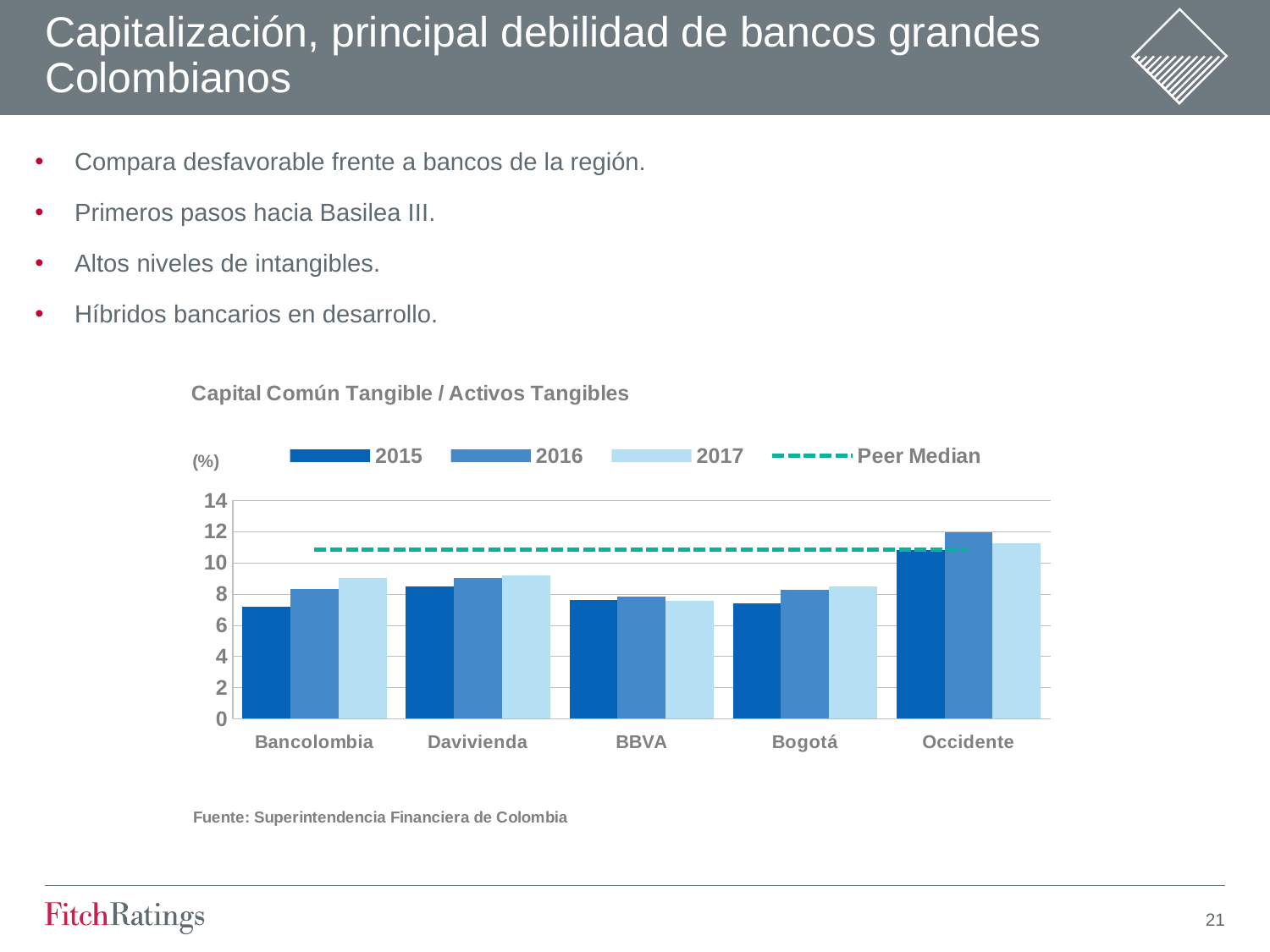
How many entries does the chart legend list? 4 Do the values for Bancolombia rise or fall from 2015 to 2017? rise Is the 2015 value for Bancolombia greater or less than 8? less What kind of chart is shown on the slide? bar chart What is the title of the chart? Capital Común Tangible / Activos Tangibles Which bank's bars are the only ones that reach the Peer Median dashed line? Occidente How many banks are shown on the x axis of the chart? 5 Which is larger, the 2016 value for Occidente or the 2016 value for BBVA? Occidente Is the 2015 value for BBVA greater or less than 10? less Which bank has the highest bars in the chart? Occidente Is the 2017 value for Davivienda greater or less than 8? greater